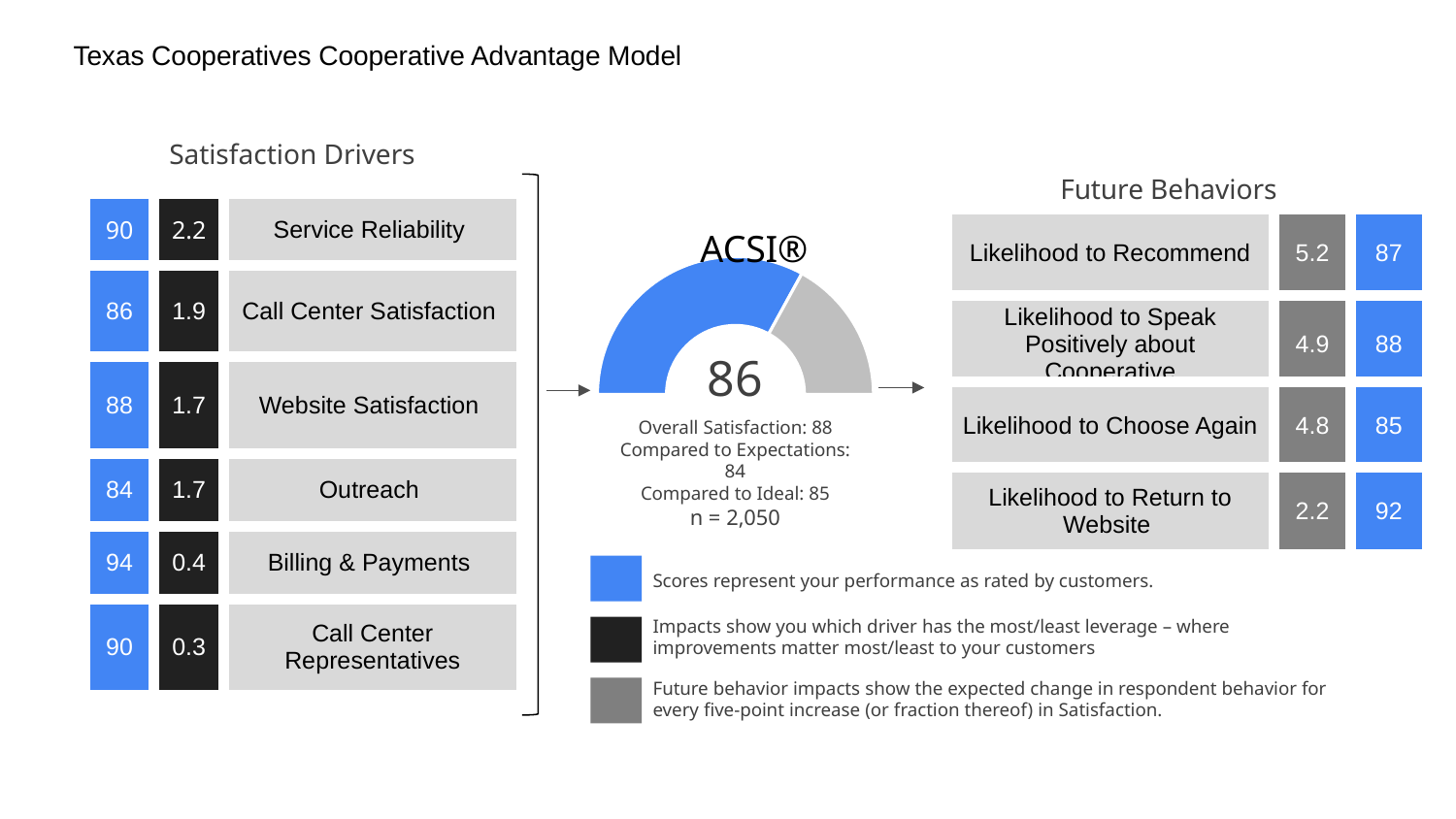
Which is larger, the Overall Satisfaction value or the Compared to Ideal value shown beneath the ACSI® gauge? Overall Satisfaction What value does the ACSI® gauge chart display? 86 Is the ACSI® gauge value greater or less than 50? greater What is the Compared to Ideal value shown beneath the ACSI® gauge? 85 Which Satisfaction Driver has the highest score in the blue boxes? Billing & Payments What is the title shown above the gauge chart? ACSI® What colour is the filled portion of the ACSI® gauge? blue What kind of chart is used to show the ACSI® score? gauge chart What is the Overall Satisfaction value shown beneath the ACSI® gauge? 88 What is the difference between the Overall Satisfaction value (88) and the Compared to Expectations value (84) shown beneath the ACSI® gauge? 4 What is the sample size (n) shown beneath the ACSI® gauge? n = 2,050 What is the Compared to Expectations value shown beneath the ACSI® gauge? 84